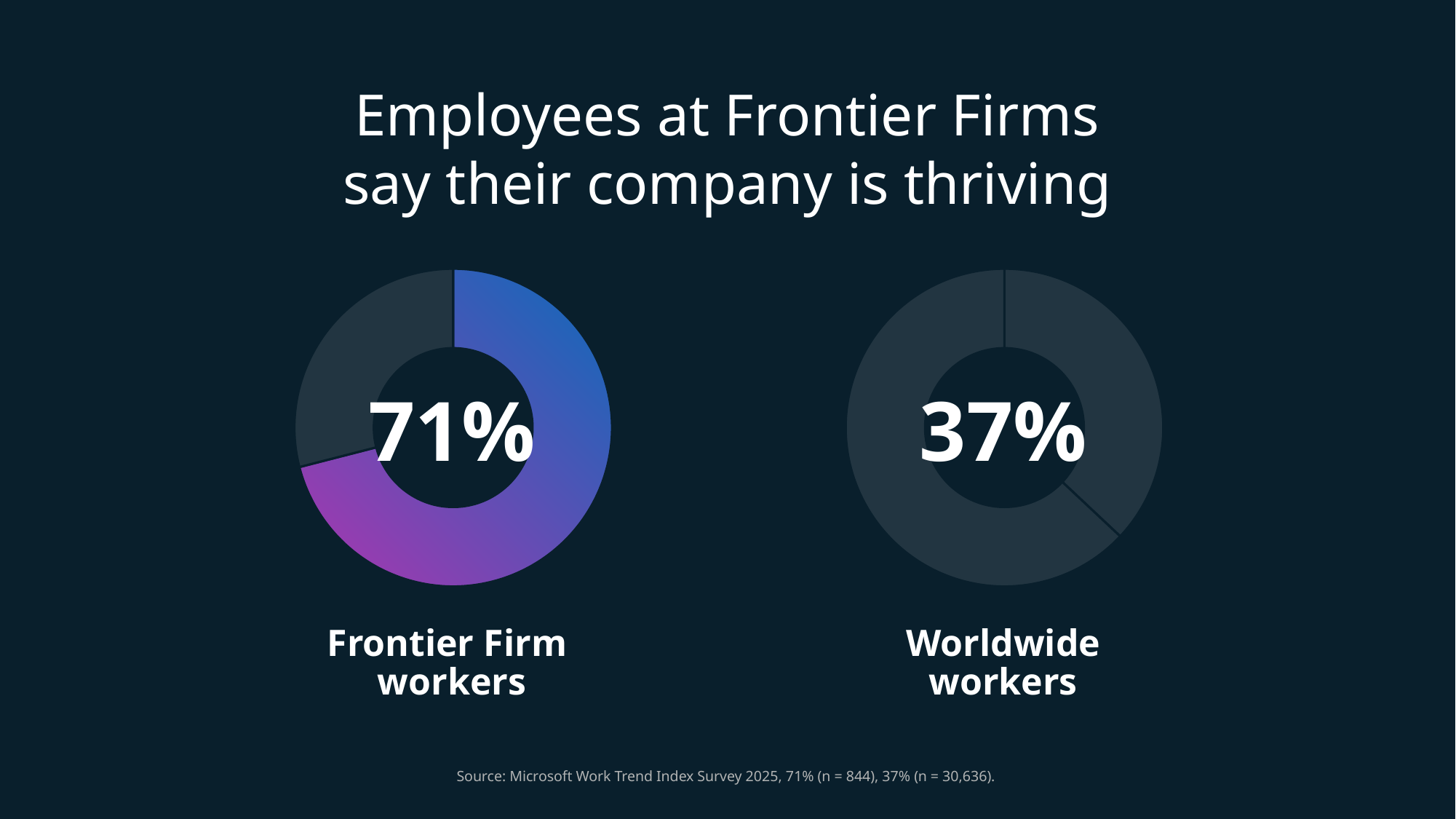
What is the title of the slide? Employees at Frontier Firms say their company is thriving What percentage of Frontier Firm workers say their company is thriving? 71% How many donut charts are shown on the slide? 2 What is the sample size (n) for the Worldwide workers figure, according to the source note? 30,636 What percentage of Worldwide workers say their company is thriving? 37% Is the value for Frontier Firm workers greater or less than 50%? greater Which group has the higher share saying their company is thriving, Frontier Firm workers or Worldwide workers? Frontier Firm workers What is the difference in percentage points between Frontier Firm workers and Worldwide workers? 34 Which group has the lowest percentage shown on the slide? Worldwide workers What kind of chart is used to show the percentages on the slide? Donut (pie) chart Is the value for Worldwide workers greater or less than 50%? less